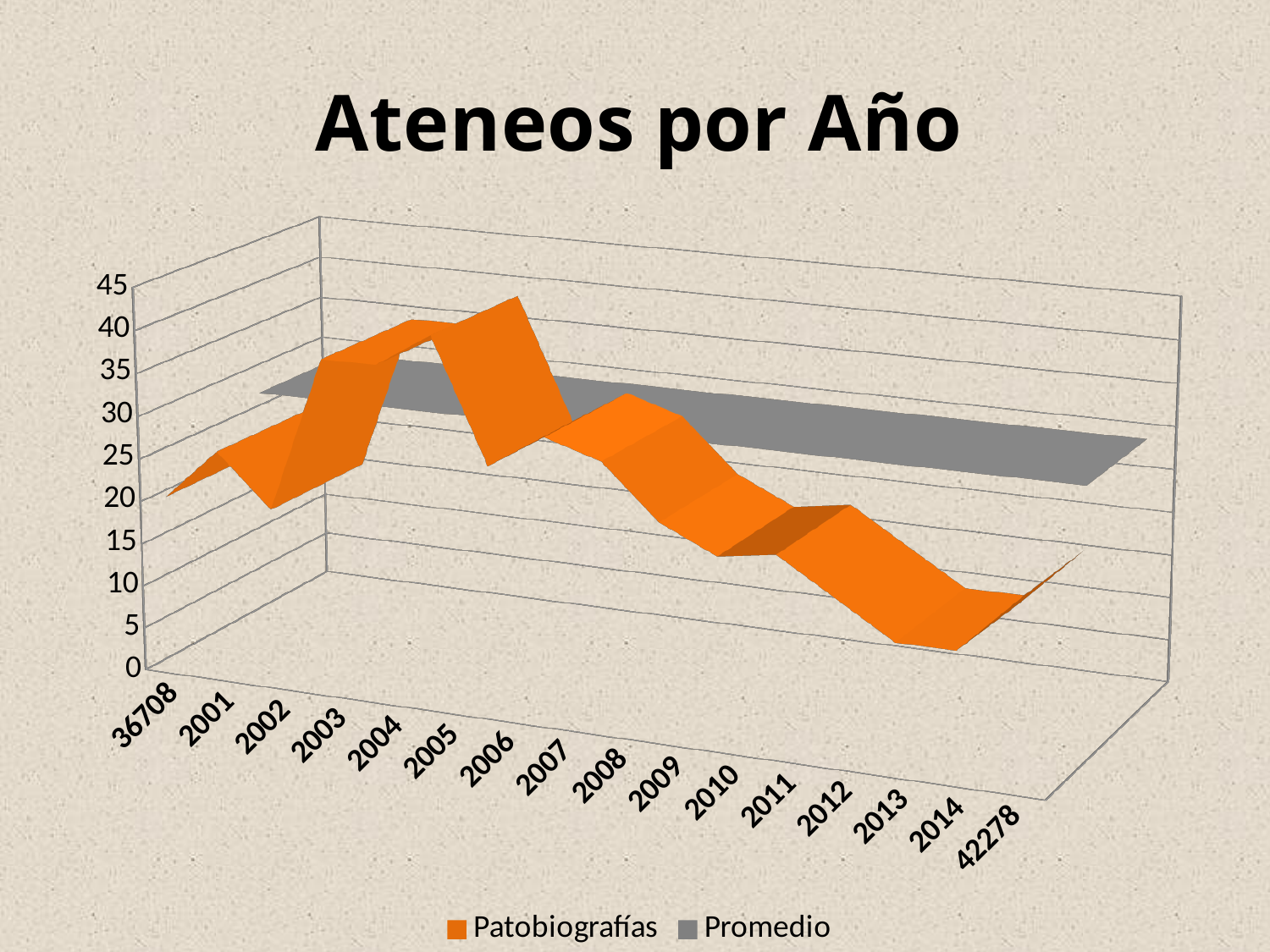
Does the Patobiografías series rise or fall from 2008 to 2013? fall Which series is shown in orange? Patobiografías How many series does the legend list? 2 How many categories are shown along the x axis? 16 What is the title of the chart? Ateneos por Año Does the Promedio series rise, fall, or stay flat across the x axis? stay flat What kind of chart is shown on the slide? line chart